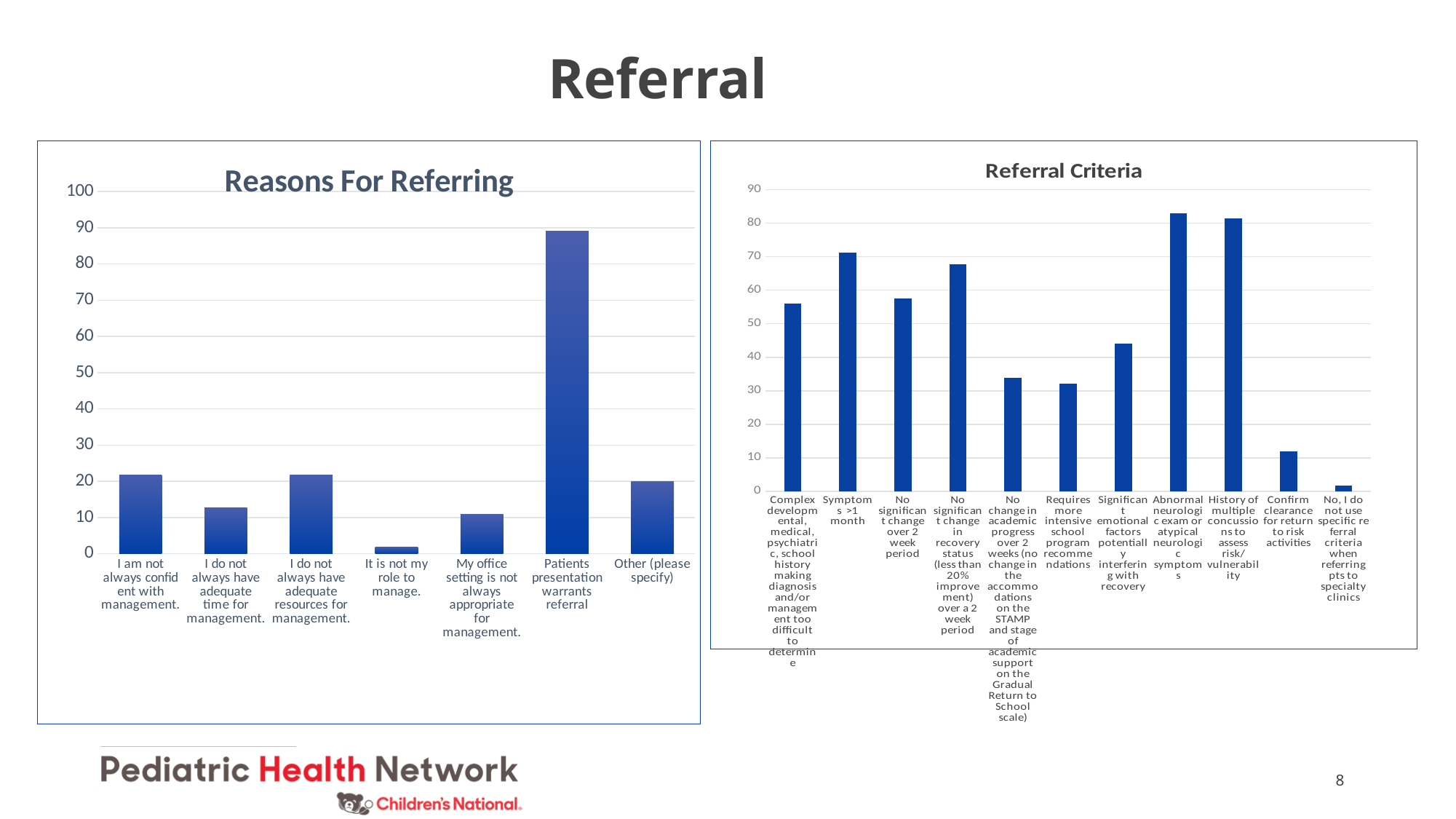
On the Reasons For Referring chart, is the value for 'Patients presentation warrants referral' greater or less than 80? greater On the Reasons For Referring chart, which reason has the highest value? Patients presentation warrants referral On the Referral Criteria chart, is the value for 'Confirm clearance for return to risk activities' greater or less than 20? less On the Referral Criteria chart, which is larger: 'Requires more intensive school program recommendations' or 'Significant emotional factors potentially interfering with recovery'? Significant emotional factors potentially interfering with recovery On the Referral Criteria chart, is the value for 'Symptoms >1 month' greater or less than 60? greater On the Referral Criteria chart, which criterion has the lowest value? No, I do not use specific referral criteria when referring pts to specialty clinics On the Reasons For Referring chart, which is larger: 'I do not always have adequate time for management.' or 'Other (please specify)'? Other (please specify) What type of chart is the Referral Criteria chart? Bar chart On the Reasons For Referring chart, how many reasons are shown? 7 On the Referral Criteria chart, how many criteria are shown? 11 On the Reasons For Referring chart, which reason has the lowest value? It is not my role to manage.